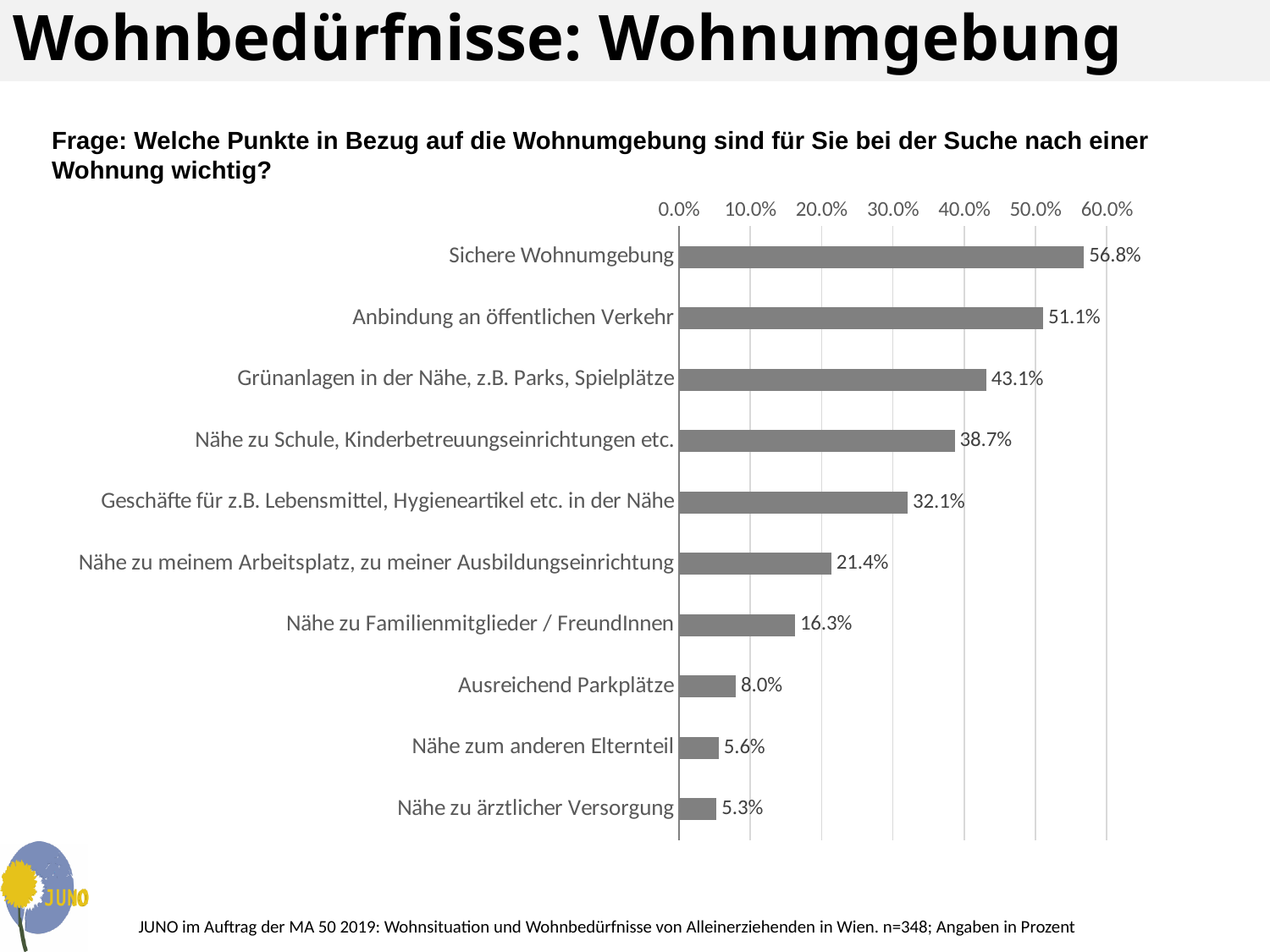
Is the value for "Nähe zu Schule, Kinderbetreuungseinrichtungen etc." greater or less than 40.0%? less What is the value for "Nähe zu Familienmitglieder / FreundInnen"? 16.3% What is the difference between the values for "Grünanlagen in der Nähe, z.B. Parks, Spielplätze" and "Nähe zu Schule, Kinderbetreuungseinrichtungen etc."? 4.4% What is the maximum value shown on the horizontal axis? 60.0% Which category has the lowest value? Nähe zu ärztlicher Versorgung What kind of chart is shown on the slide? bar chart What is the value for "Sichere Wohnumgebung"? 56.8% How many categories are shown in the chart? 10 What is the value for "Ausreichend Parkplätze"? 8.0% What is the difference between the values for "Sichere Wohnumgebung" and "Anbindung an öffentlichen Verkehr"? 5.7% Which category has the highest value? Sichere Wohnumgebung Which is larger: the value for "Geschäfte für z.B. Lebensmittel, Hygieneartikel etc. in der Nähe" or the value for "Nähe zu meinem Arbeitsplatz, zu meiner Ausbildungseinrichtung"? Geschäfte für z.B. Lebensmittel, Hygieneartikel etc. in der Nähe